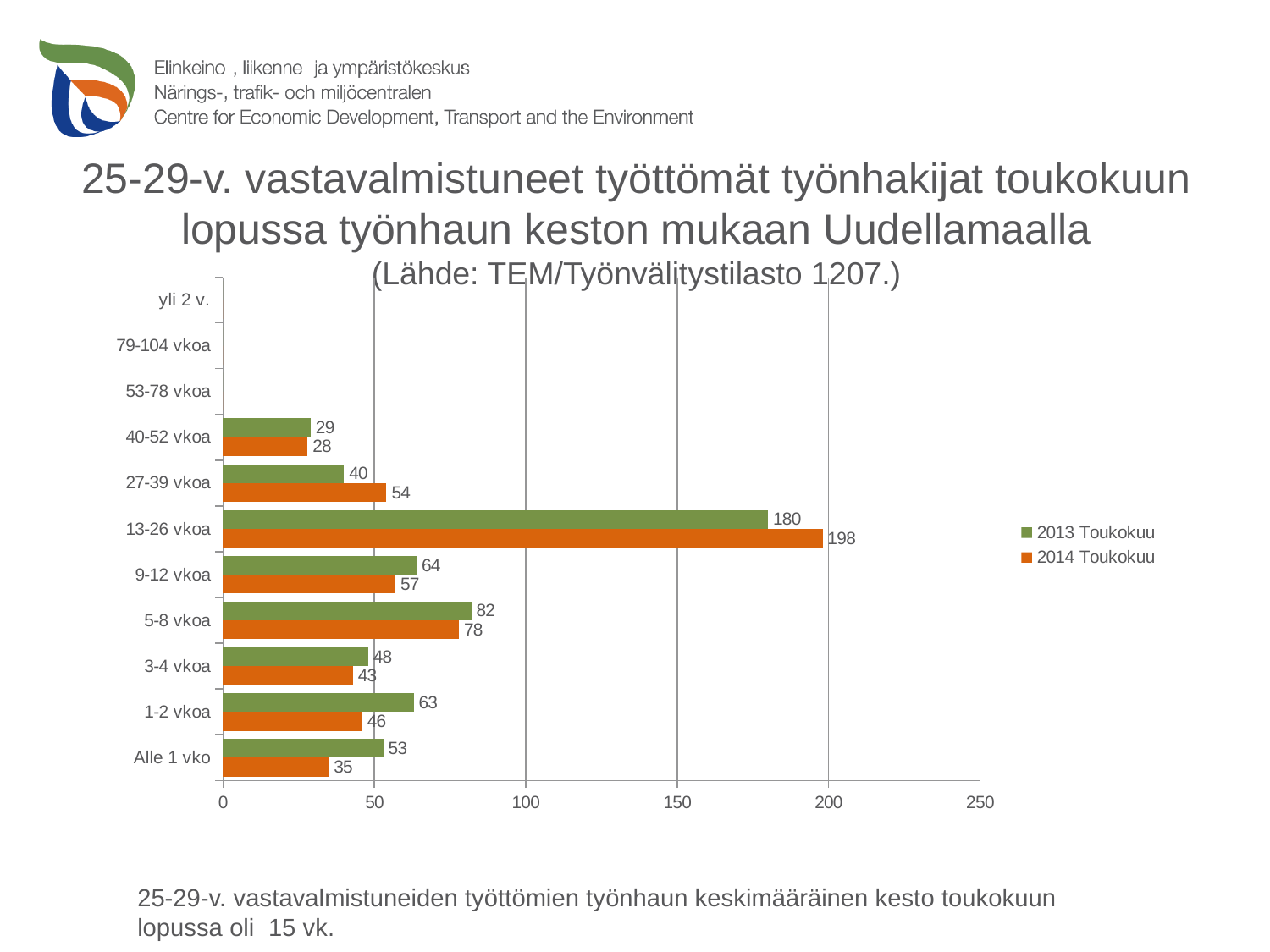
What is the difference between the 2014 Toukokuu and 2013 Toukokuu values for 13-26 vkoa? 18 What is the value for 13-26 vkoa in the 2014 Toukokuu series? 198 What is the value for 5-8 vkoa in the 2013 Toukokuu series? 82 How many series does the legend list? 2 Is the 2013 Toukokuu value for 13-26 vkoa greater or less than 150? greater Which category has the highest value in the 2013 Toukokuu series? 13-26 vkoa What kind of chart is shown on the slide? Bar chart What is the value for Alle 1 vko in the 2014 Toukokuu series? 35 How many categories are listed on the vertical axis of the chart? 11 Among the categories with labelled bars, which has the lowest value in the 2014 Toukokuu series? 40-52 vkoa For 27-39 vkoa, which series has the larger value, 2013 Toukokuu or 2014 Toukokuu? 2014 Toukokuu Which colour represents the 2014 Toukokuu series in the chart? Orange